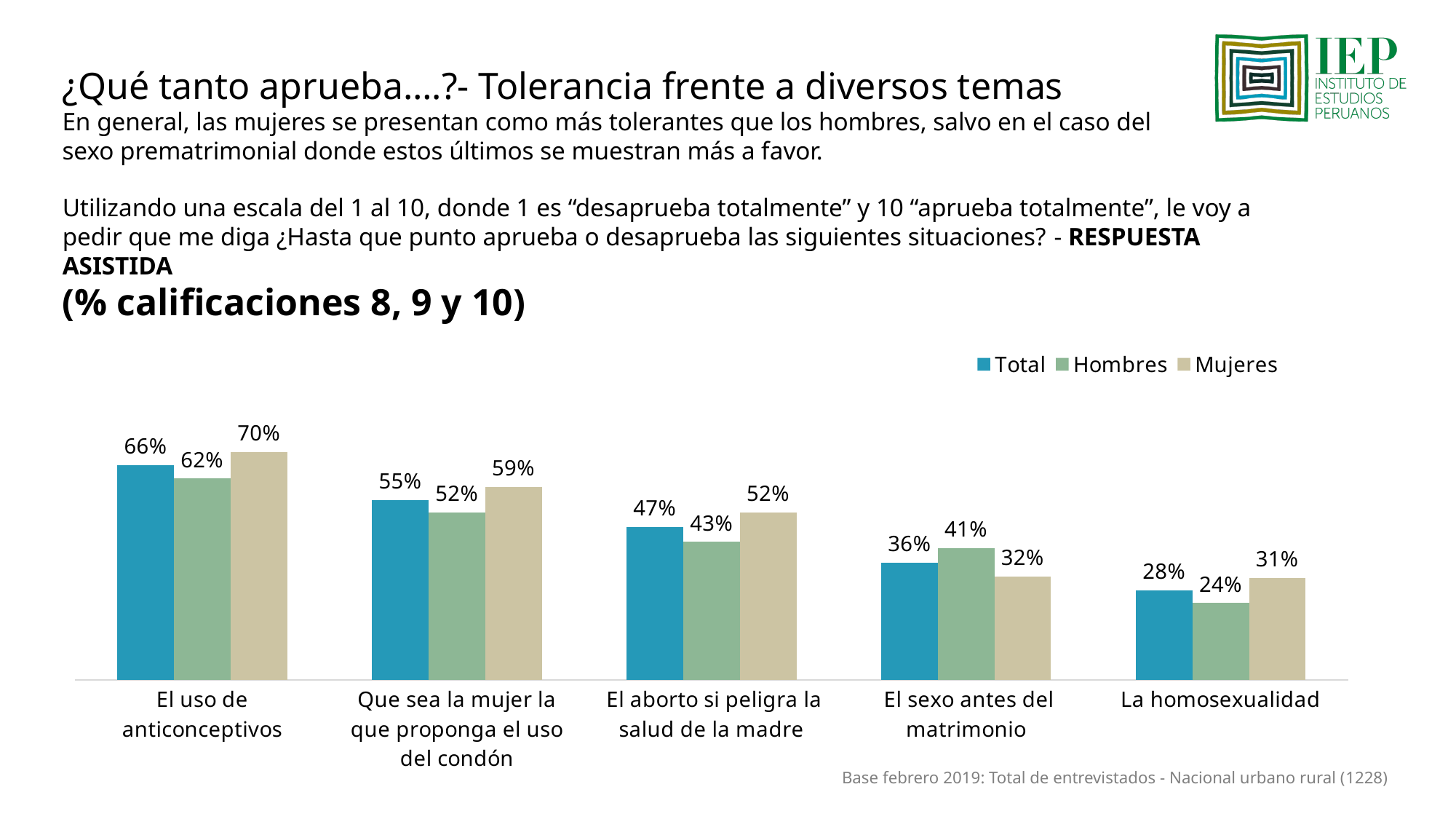
For "El sexo antes del matrimonio", which is larger, the Hombres value or the Mujeres value? Hombres How many series does the legend list? 3 Which category has the highest Total value? El uso de anticonceptivos Which category has the lowest Hombres value? La homosexualidad What kind of chart is shown on the slide? Bar chart What is the Total value for "El uso de anticonceptivos"? 66% What is the difference between the Mujeres and Hombres values for "Que sea la mujer la que proponga el uso del condón"? 7 percentage points What is the Hombres value for "El sexo antes del matrimonio"? 41% Which series is shown in blue in the legend? Total What is the Mujeres value for "El aborto si peligra la salud de la madre"? 52% Do the Total values rise or fall from left to right along the x axis? Fall How many categories are shown on the x axis? 5